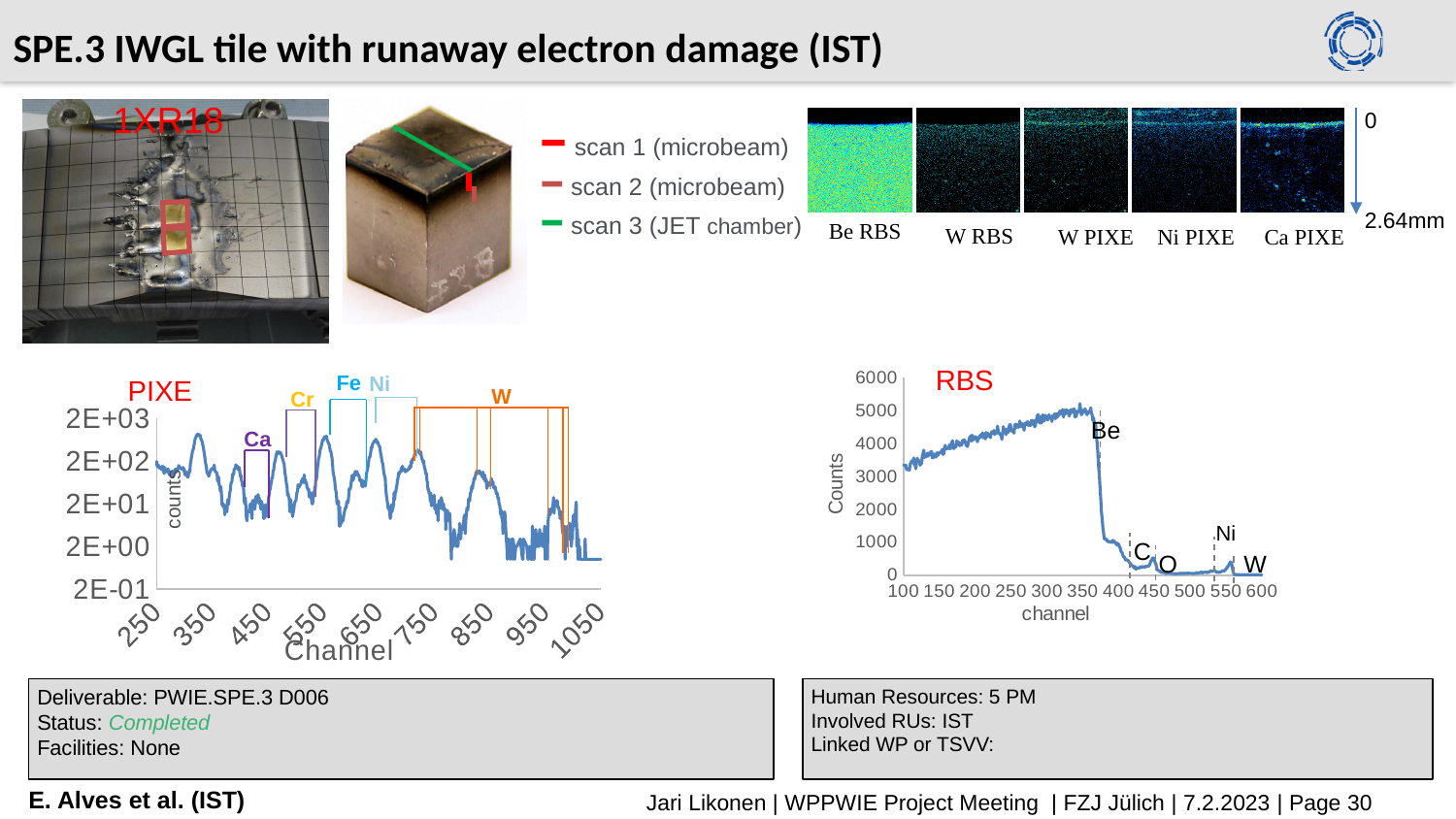
What kind of chart is the RBS chart? line chart In the RBS chart, which element label is placed at the sharp drop in counts near channel 400? Be In the PIXE chart, which element label spans the widest range of channels? W In the RBS chart, is the value at channel 300 greater or less than 4000? greater In the RBS chart, is the value at channel 500 greater or less than 1000? less What kind of chart is the PIXE chart? line chart In the PIXE chart, is the value at channel 1050 greater or less than 2E+01? less In the RBS chart, do the counts rise or fall between channel 100 and channel 350? rise In the RBS chart, do the counts rise or fall between channel 350 and channel 450? fall